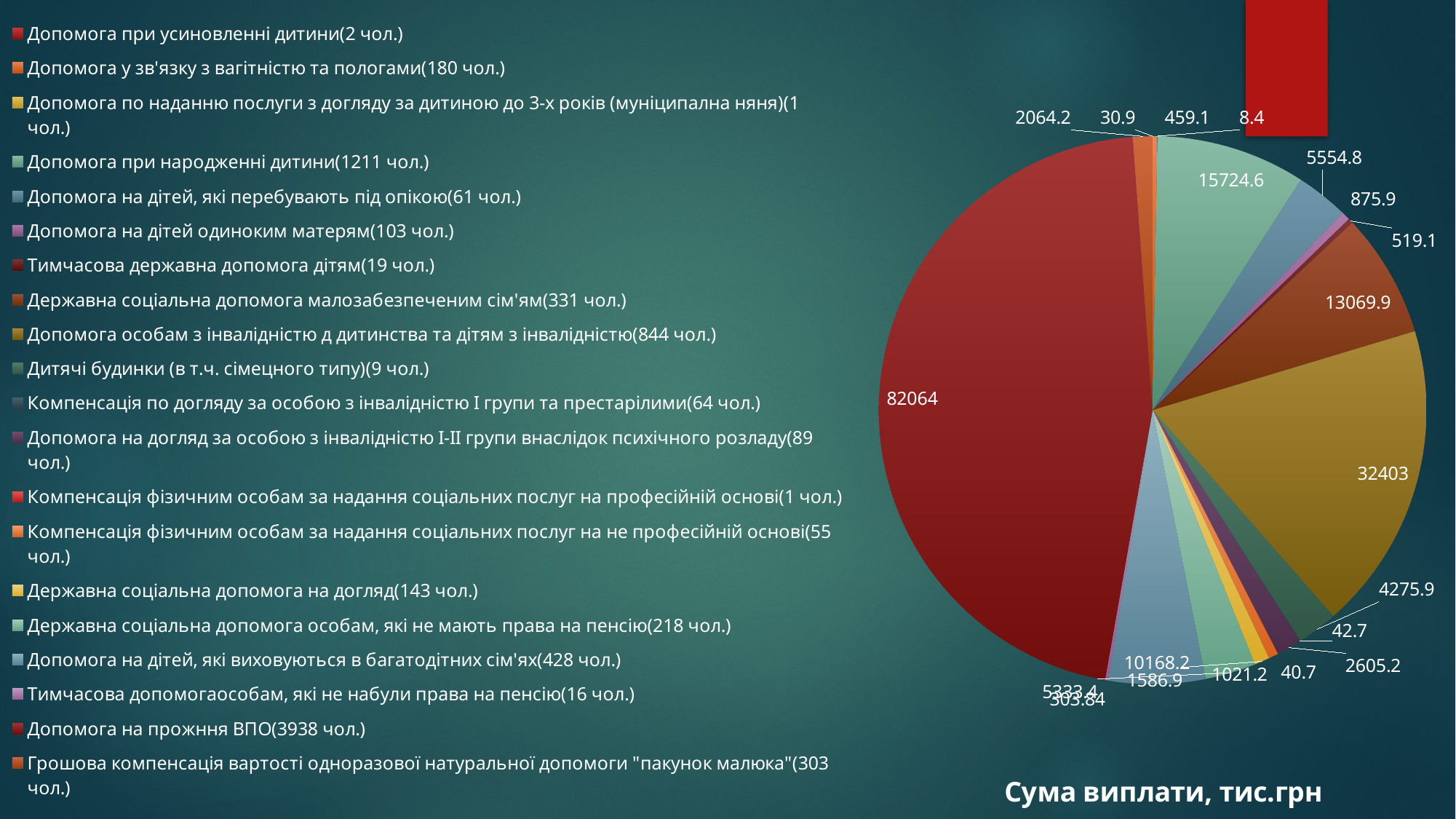
What is the value for 'Допомога на прожння ВПО(3938 чол.)'? 82064 What kind of chart is shown on the slide? pie chart What is the value for 'Державна соціальна допомога малозабезпеченим сім'ям(331 чол.)'? 13069.9 Which category has the smallest slice of the pie? Допомога по наданню послуги з догляду за дитиною до 3-х років (муніципална няня)(1 чол.) Which category has the largest slice of the pie? Допомога на прожння ВПО(3938 чол.) What is the difference between the values for 'Допомога особам з інвалідністю д дитинства та дітям з інвалідністю(844 чол.)' and 'Державна соціальна допомога малозабезпеченим сім'ям(331 чол.)'? 19333.1 How many categories does the legend of the pie chart list? 20 What is the value for 'Допомога у зв'язку з вагітністю та пологами(180 чол.)'? 459.1 What is the title of the chart? Сума виплати, тис.грн What is the value for 'Допомога особам з інвалідністю д дитинства та дітям з інвалідністю(844 чол.)'? 32403 What is the value for 'Допомога при народженні дитини(1211 чол.)'? 15724.6 Which is larger: the value for 'Допомога при народженні дитини(1211 чол.)' or for 'Державна соціальна допомога особам, які не мають права на пенсію(218 чол.)'? Допомога при народженні дитини(1211 чол.)